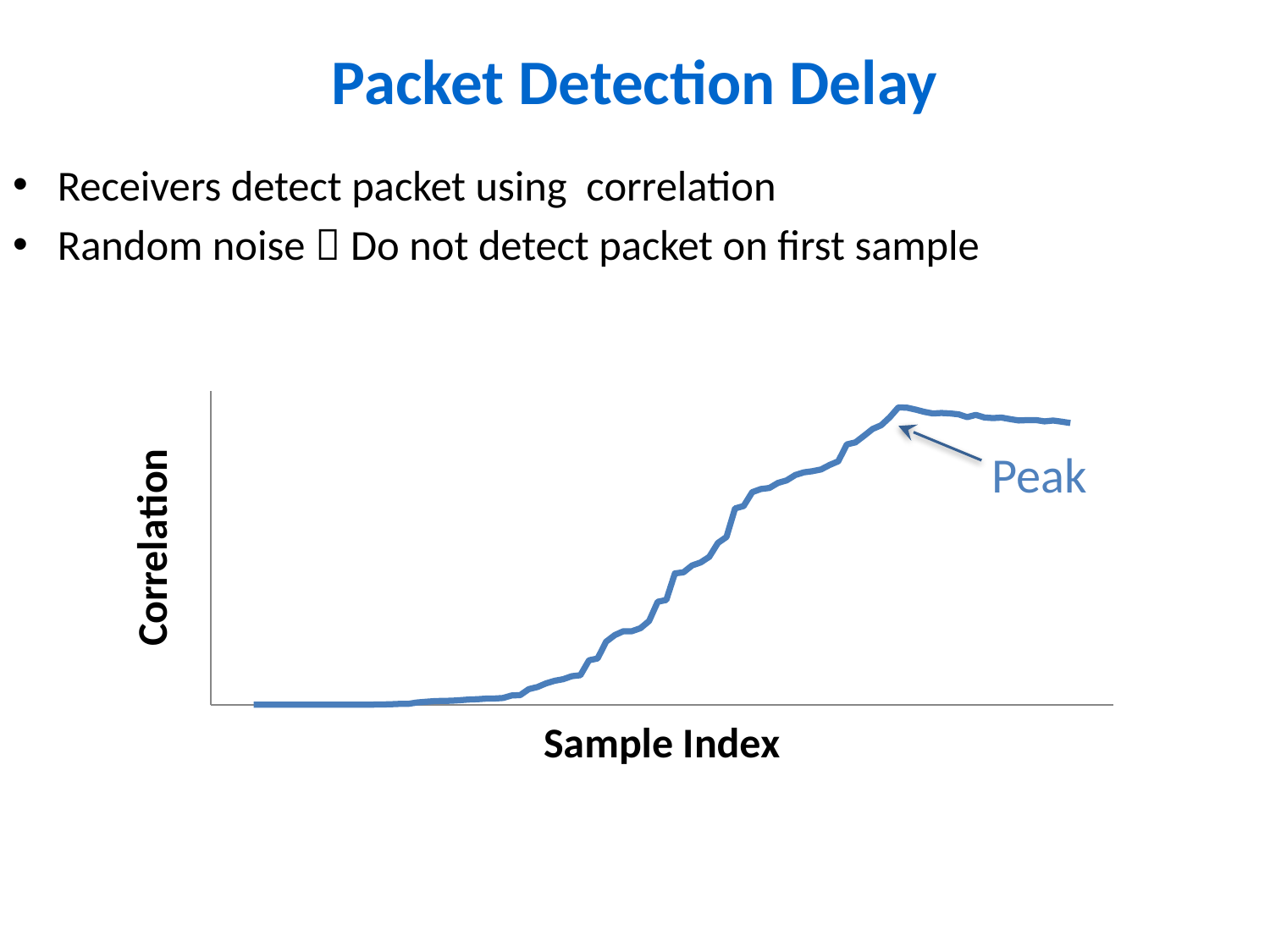
Is the correlation at the left end of the line higher or lower than at the right end? lower Is the lowest part of the line near the left or near the right of the chart? near the left How many lines are plotted on the chart? 1 What kind of chart is shown on the slide? line chart What word does the arrow annotation on the chart point to the highest point with? Peak Does the correlation generally rise or fall as the sample index increases? rise Is the highest point of the line near the left or near the right of the chart? near the right What are the titles of the y axis and the x axis of the chart? Correlation and Sample Index After the point labelled Peak, does the line rise or fall? fall